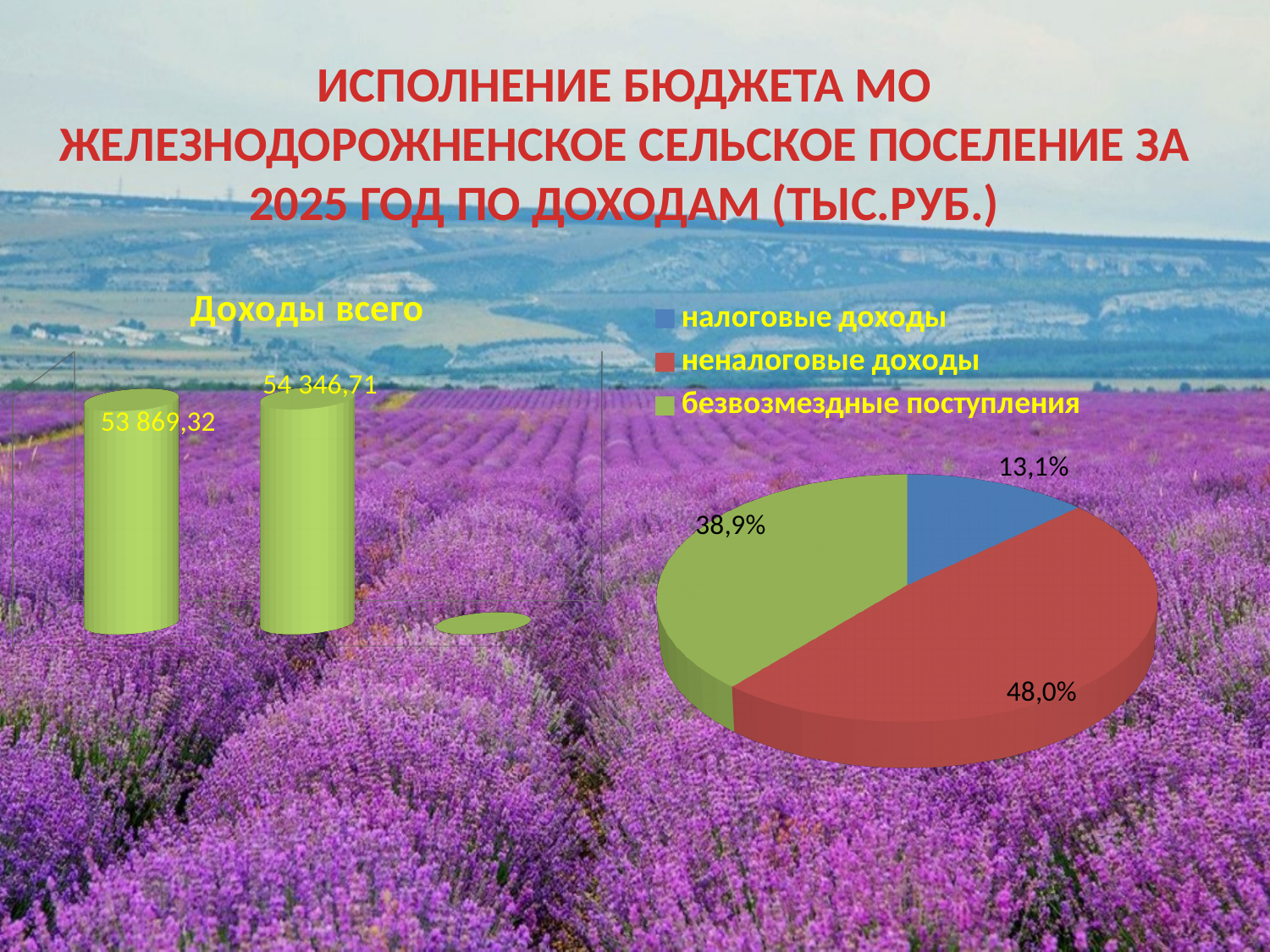
On the pie chart on the right of the slide, which category has the smallest slice? налоговые доходы On the bar chart titled "Доходы всего", which bar is taller, the left one or the right one? the right one On the pie chart on the right of the slide, what share is shown for "налоговые доходы"? 13,1% How many entries does the legend of the pie chart on the right of the slide list? 3 On the pie chart on the right of the slide, what colour is the slice for "безвозмездные поступления"? green On the pie chart on the right of the slide, which category has the largest slice? неналоговые доходы On the pie chart on the right of the slide, what share is shown for "безвозмездные поступления"? 38,9% On the pie chart on the right of the slide, what share is shown for "неналоговые доходы"? 48,0% On the bar chart titled "Доходы всего", what value is printed on the left bar? 53 869,32 What kind of chart is the chart titled "Доходы всего" on the left of the slide? bar chart On the bar chart titled "Доходы всего", what value is printed on the right bar? 54 346,71 On the bar chart titled "Доходы всего", what is the difference between the right bar (54 346,71) and the left bar (53 869,32)? 477,39